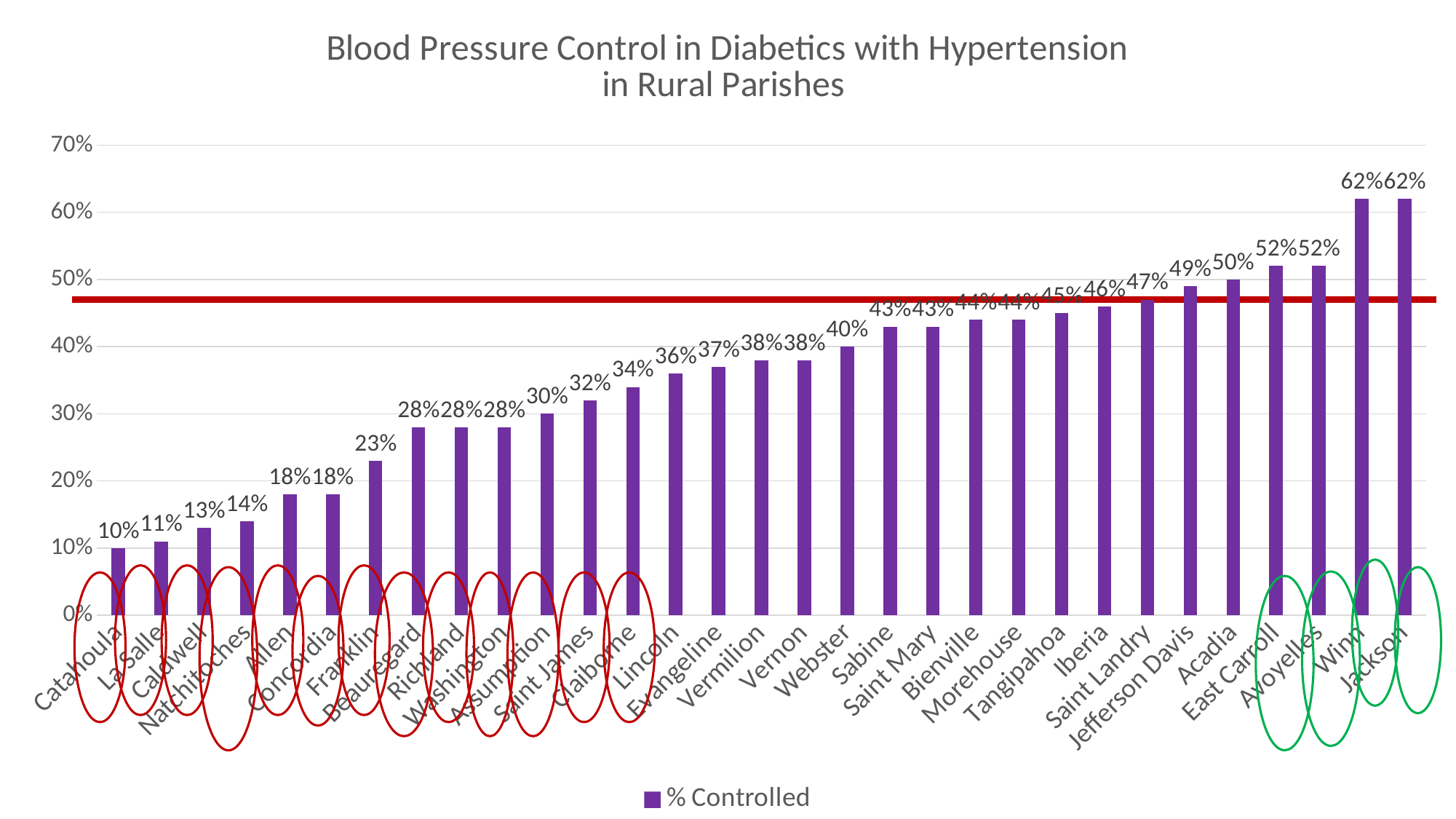
What is the % Controlled value for Acadia? 50% What is the difference between the % Controlled values for Jackson and Catahoula? 52 percentage points How many series does the legend list? 1 What kind of chart is shown on the slide? Bar chart What is the name of the series shown in the legend? % Controlled Which parish has the lowest % Controlled value? Catahoula How many parishes are shown on the x axis? 31 Is the value for Saint Landry greater or less than 60%? less Do the values rise or fall moving from left to right along the x axis? Rise What is the % Controlled value for Webster? 40% Which has a higher % Controlled value, Lincoln or Iberia? Iberia What is the % Controlled value for Franklin? 23%